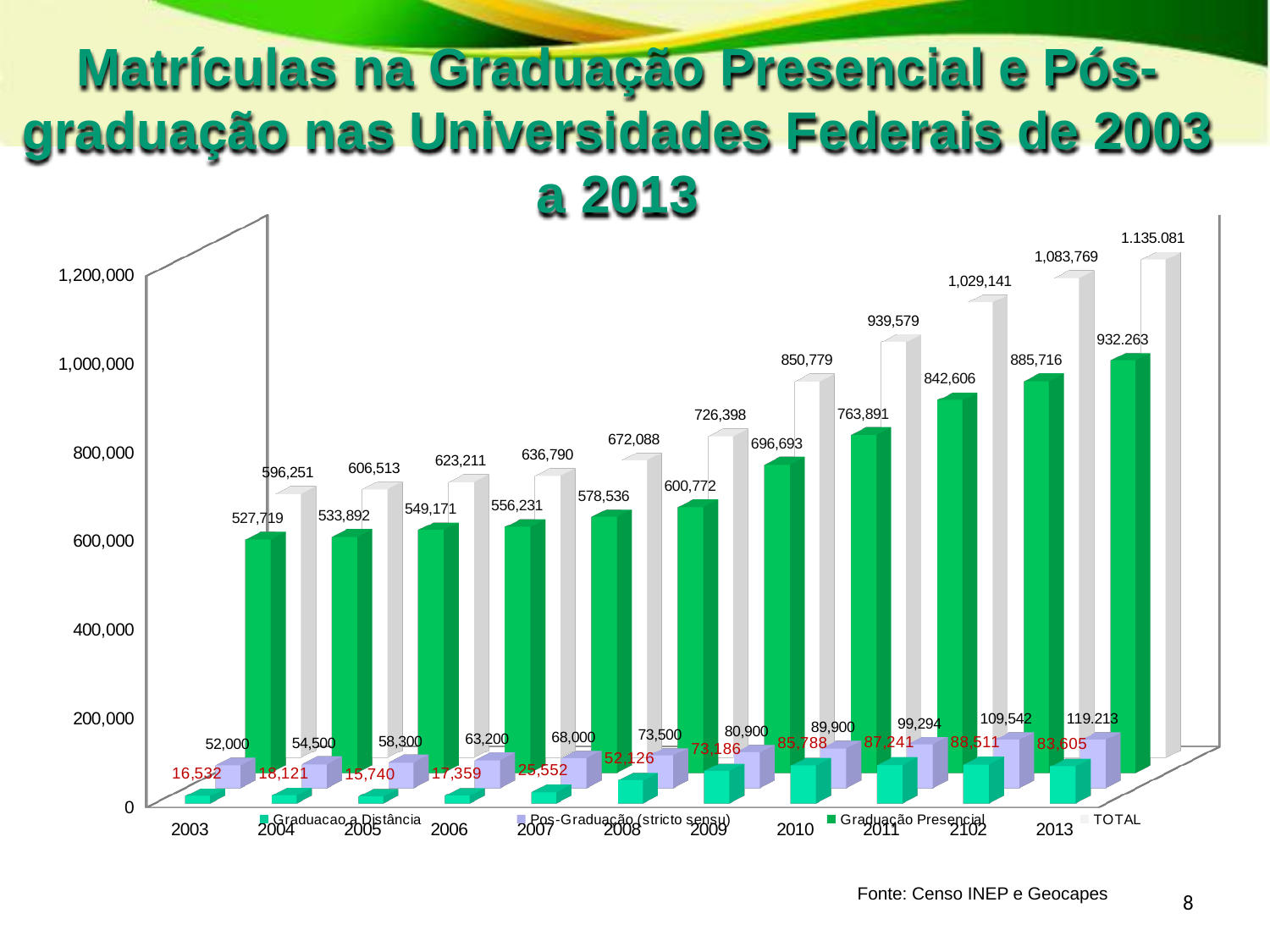
In which year is the value for Graduacao a Distância lowest? 2005 What is the difference between the Graduação Presencial values for 2010 and 2009? 67,198 How many series does the legend list? 4 What is the value for Graduação Presencial in 2003? 527,719 What kind of chart is shown on the slide? bar chart Is the value for Graduação Presencial in 2009 greater or less than 600,000? greater What is the TOTAL value shown for 2013? 1.135.081 In which year is the TOTAL highest? 2013 How many years are shown on the x axis? 11 What is the value for Pos-Graduação (stricto sensu) in 2008? 73,500 Does the TOTAL series rise or fall from 2003 to 2013? rise In 2010, which is larger: Pos-Graduação (stricto sensu) or Graduacao a Distância? Pos-Graduação (stricto sensu)